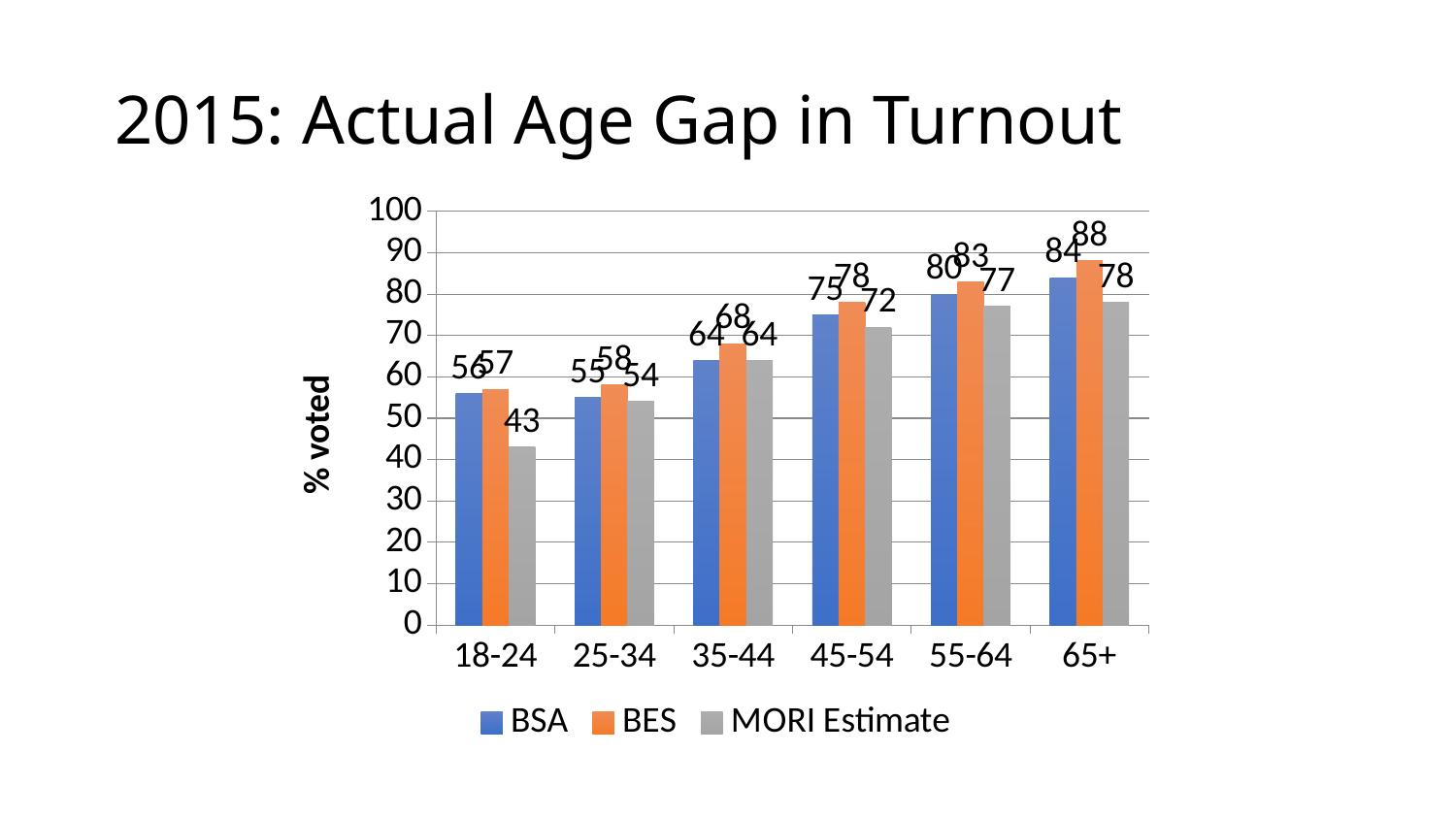
For the 55-64 age group, which series has the larger value, BSA or BES? BES What is the difference between the BES and MORI Estimate values for the 65+ age group? 10 How many age groups are shown on the x axis? 6 Which age group has the highest BES value? 65+ What is the BSA value for the 45-54 age group? 75 What is the MORI Estimate value for the 18-24 age group? 43 Is the BSA value for the 65+ age group greater or less than 80? greater How many series does the legend list? 3 Do the BES values rise or fall as the age groups get older along the x axis? rise Which age group has the lowest MORI Estimate value? 18-24 What kind of chart is shown on the slide? bar chart What is the BES value for the 65+ age group? 88